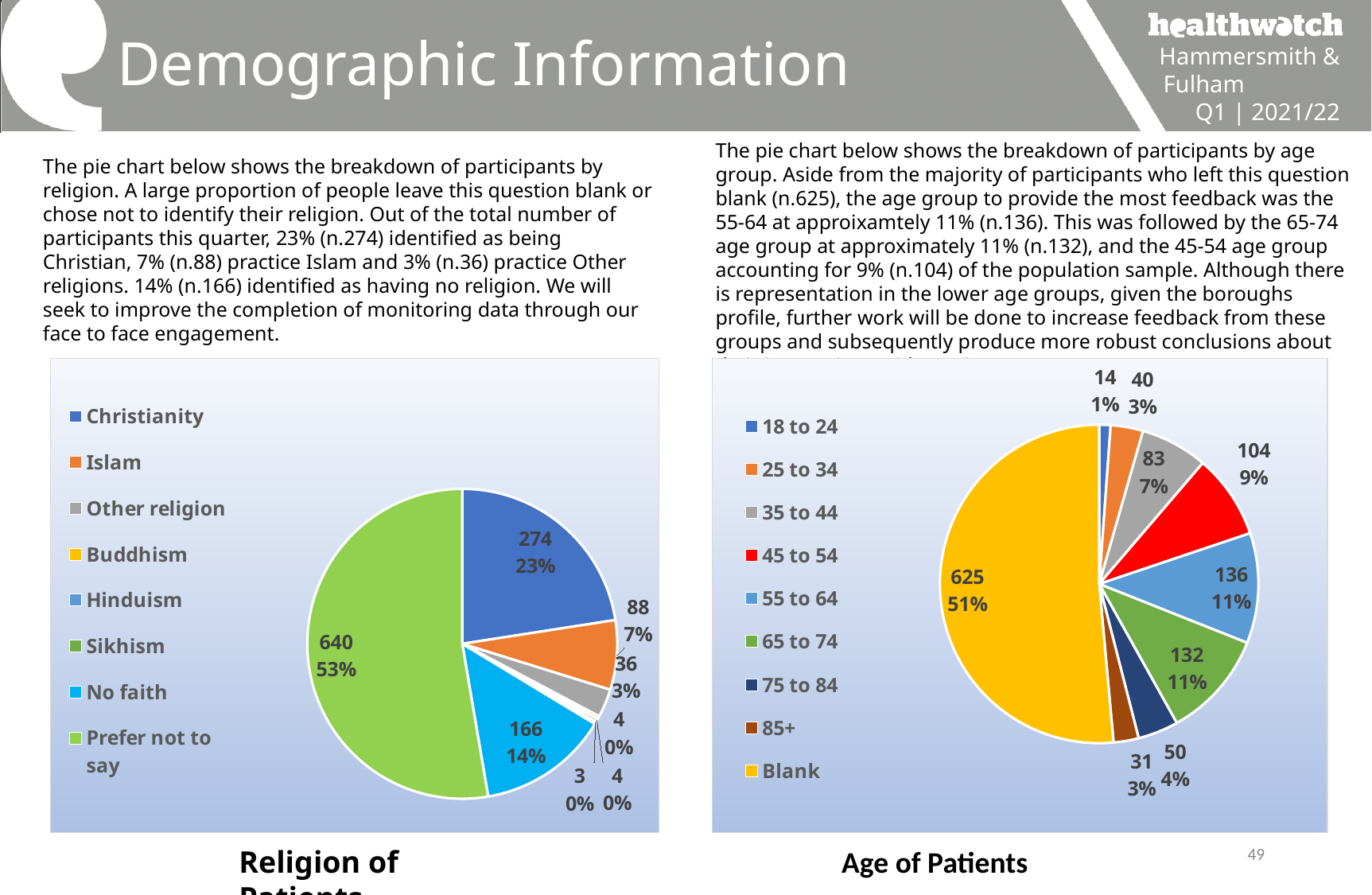
What type of chart is the Age of Patients chart? Pie chart On the Age of Patients chart, which age group (excluding Blank) has the smallest slice? 18 to 24 On the Religion of Patients chart, what is the difference between the Christianity count and the No faith count? 108 On the Religion of Patients chart, which is larger, Islam or Other religion? Islam On the Religion of Patients chart, how many participants identified as Christianity? 274 How many categories does the legend of the Religion of Patients chart list? 8 On the Age of Patients chart, how many participants are in the 55 to 64 age group? 136 On the Age of Patients chart, which is larger, 75 to 84 or 85+? 75 to 84 On the Religion of Patients chart, what percentage share does the Prefer not to say slice have? 53% On the Age of Patients chart, what is the difference between the 45 to 54 count and the 35 to 44 count? 21 On the Religion of Patients chart, which category has the largest slice? Prefer not to say On the Age of Patients chart, what percentage share does the Blank slice have? 51%